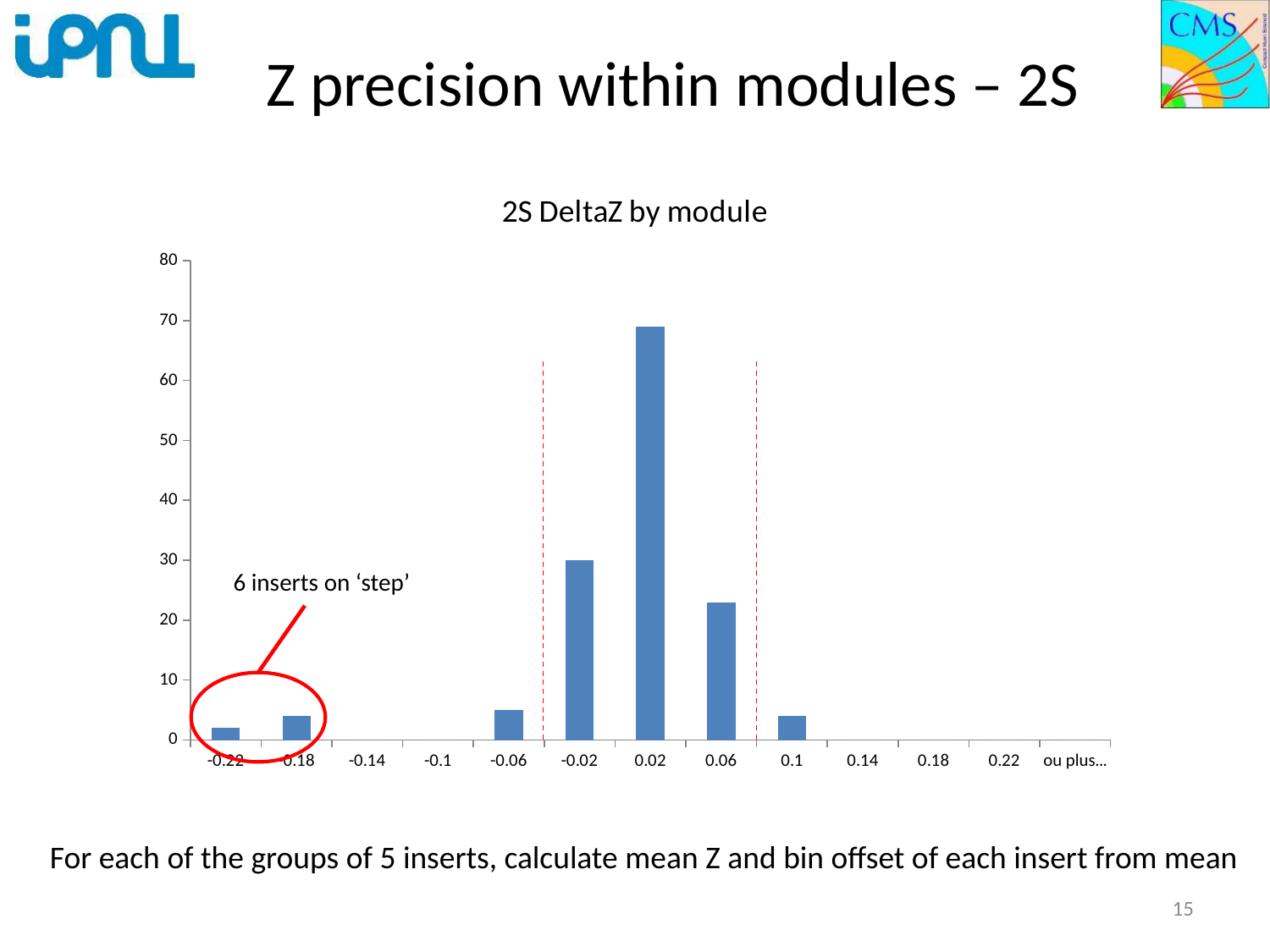
Which has the larger value, -0.02 or 0.06? -0.02 What kind of chart is shown on the slide? bar chart Is the value for -0.06 greater or less than 10? less How many categories are shown on the x axis? 13 Which has the larger value, 0.02 or -0.02? 0.02 Is the value for -0.02 greater or less than 20? greater Which x-axis category has the highest bar? 0.02 Is the value for 0.1 greater or less than 10? less What does the annotation pointing to the circled bars on the left of the chart say? 6 inserts on 'step' What is the title of the chart? 2S DeltaZ by module